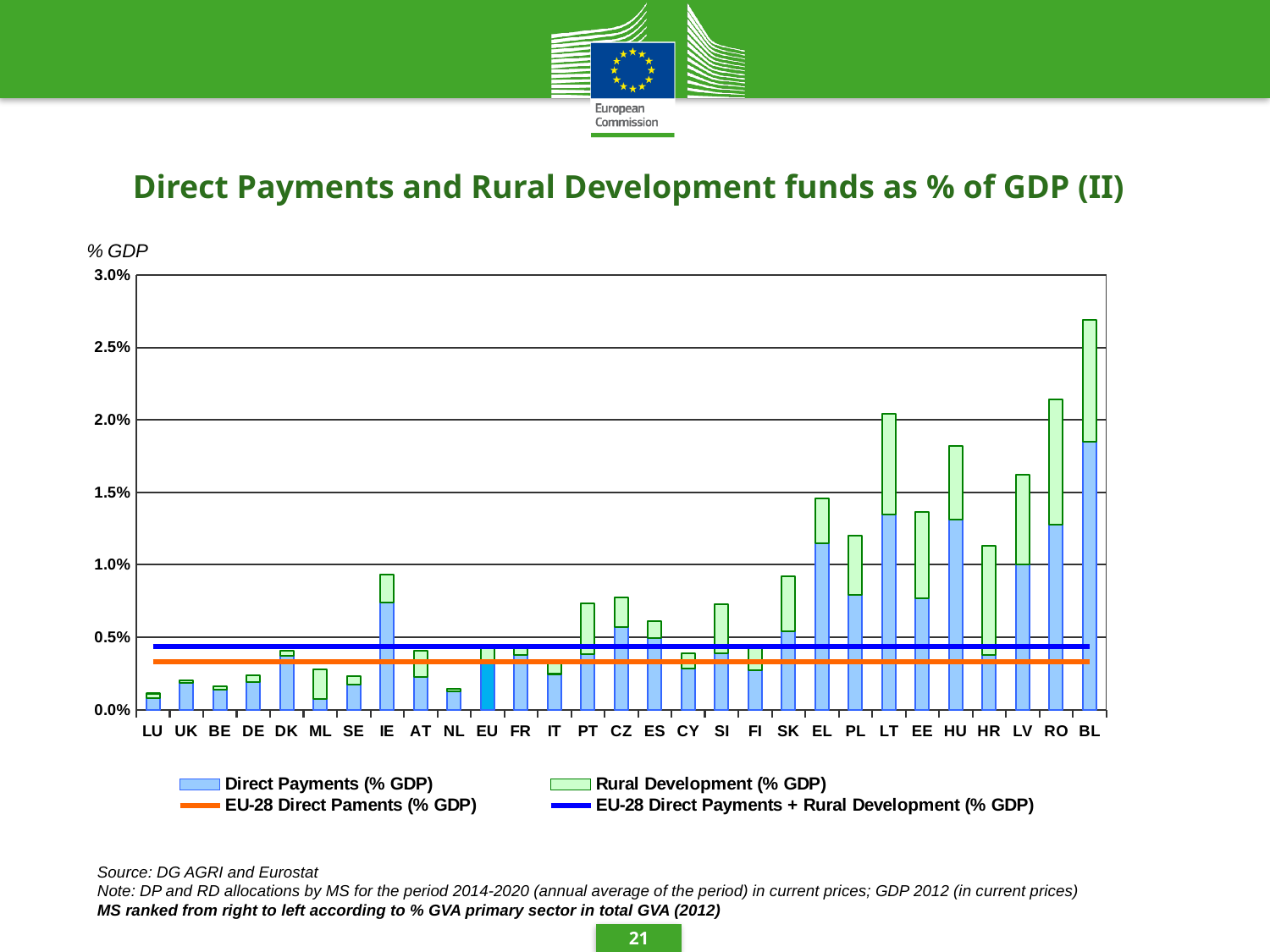
What kind of chart is shown on the slide? Stacked bar chart Is the total bar for IE greater or less than 1.0%? less How many entries does the legend list? 4 How many member state/EU categories are shown along the x axis? 29 Which category has the lowest total bar? LU Which has the larger total bar, RO or HU? RO Is the total bar for BL greater or less than 2.5%? greater Which category has the highest total bar (Direct Payments plus Rural Development)? BL What is the label on the y axis of the chart? % GDP Is the total bar for LU greater or less than 0.5%? less Do the total bar values generally rise or fall moving from left to right along the x axis? Rise